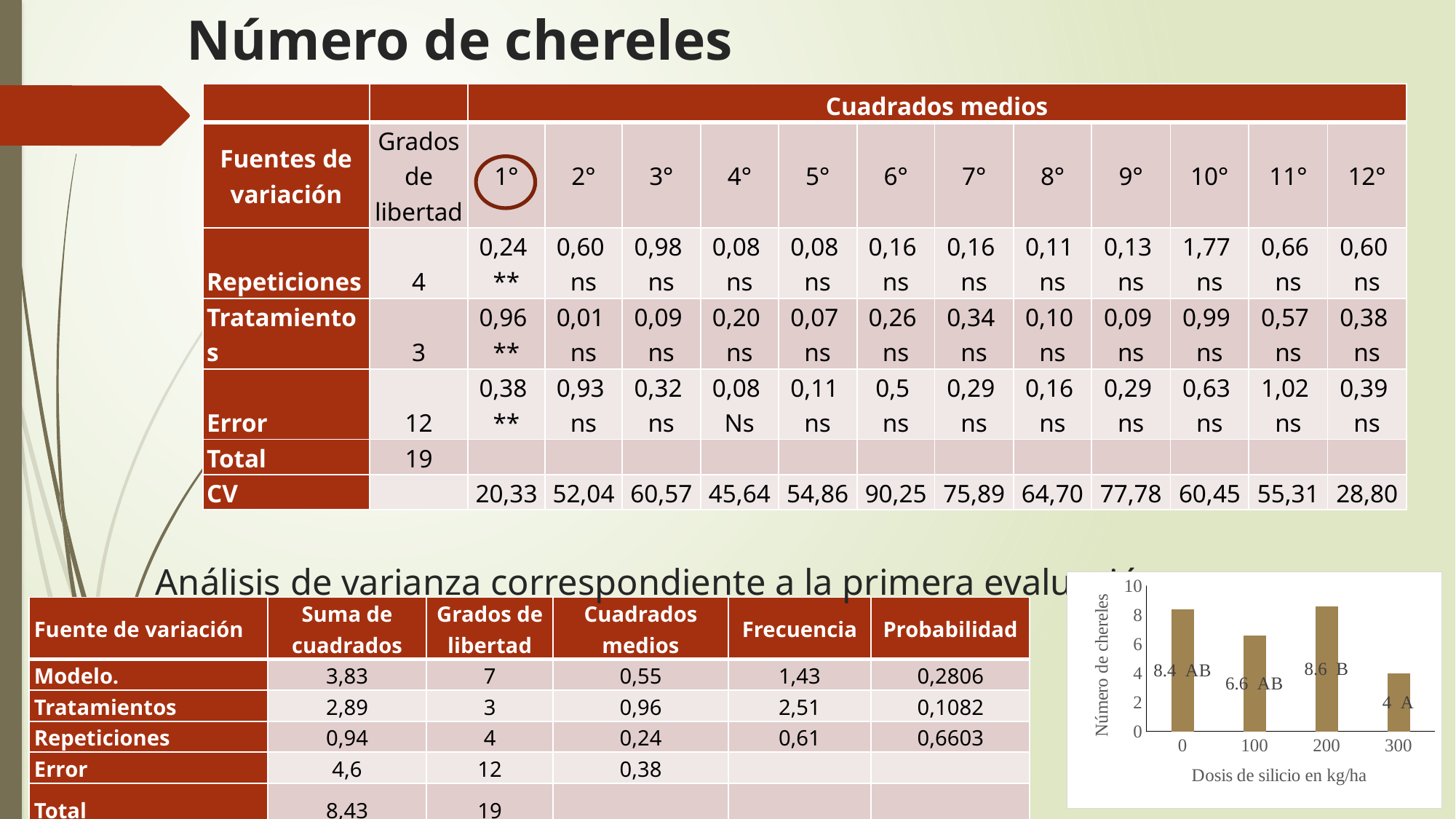
What is the value for the 100 kg/ha dose in the bar chart? 6.6 What is the x-axis title of the bar chart? Dosis de silicio en kg/ha How many silicon doses are shown in the bar chart? 4 Is the value for the 300 kg/ha dose in the bar chart greater or less than 6? less What is the value for the 0 kg/ha dose in the bar chart? 8.4 What is the difference between the values for the 200 and 300 kg/ha doses in the bar chart? 4.6 What kind of chart is shown at the bottom right of the slide? bar chart Which silicon dose has the highest number of chereles in the bar chart? 200 Which has a larger value in the bar chart, the 0 kg/ha dose or the 100 kg/ha dose? 0 What is the value for the 300 kg/ha dose in the bar chart? 4 What is the value for the 200 kg/ha dose in the bar chart? 8.6 Which silicon dose has the lowest number of chereles in the bar chart? 300